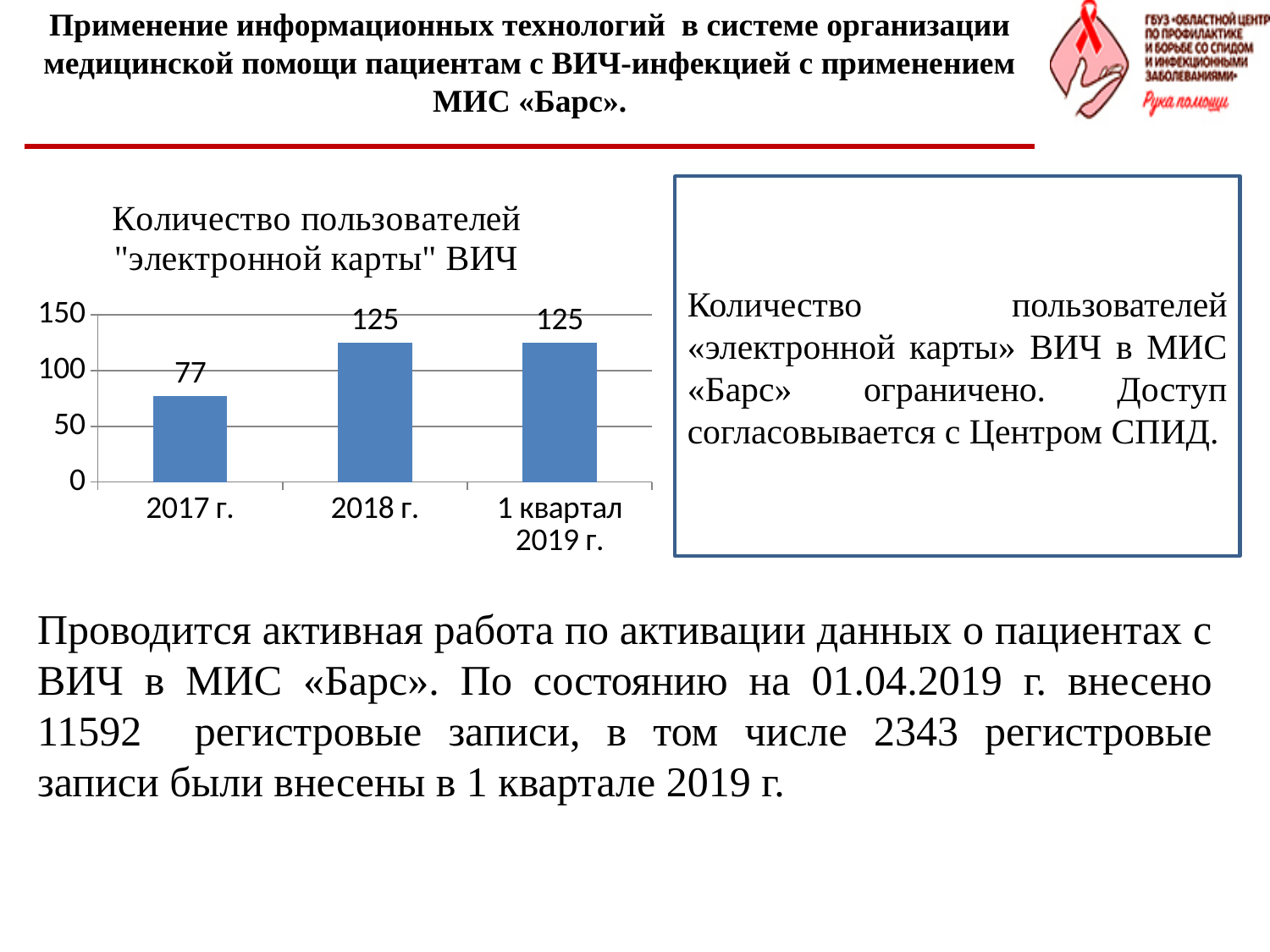
What is the value for 1 квартал 2019 г.? 125 What is the value for 2018 г.? 125 What is the value for 2017 г.? 77 How many categories are shown on the x axis? 3 Is the value for 2017 г. greater or less than 100? less Is the value for 2018 г. greater or less than 100? greater What is the title of the chart? Количество пользователей "электронной карты" ВИЧ Which is larger, the value for 2017 г. or the value for 2018 г.? 2018 г. Do the values rise or fall from 2017 г. to 2018 г.? rise Which category has the lowest value? 2017 г. What kind of chart is shown on the slide? bar chart What is the difference between the values for 2018 г. and 2017 г.? 48